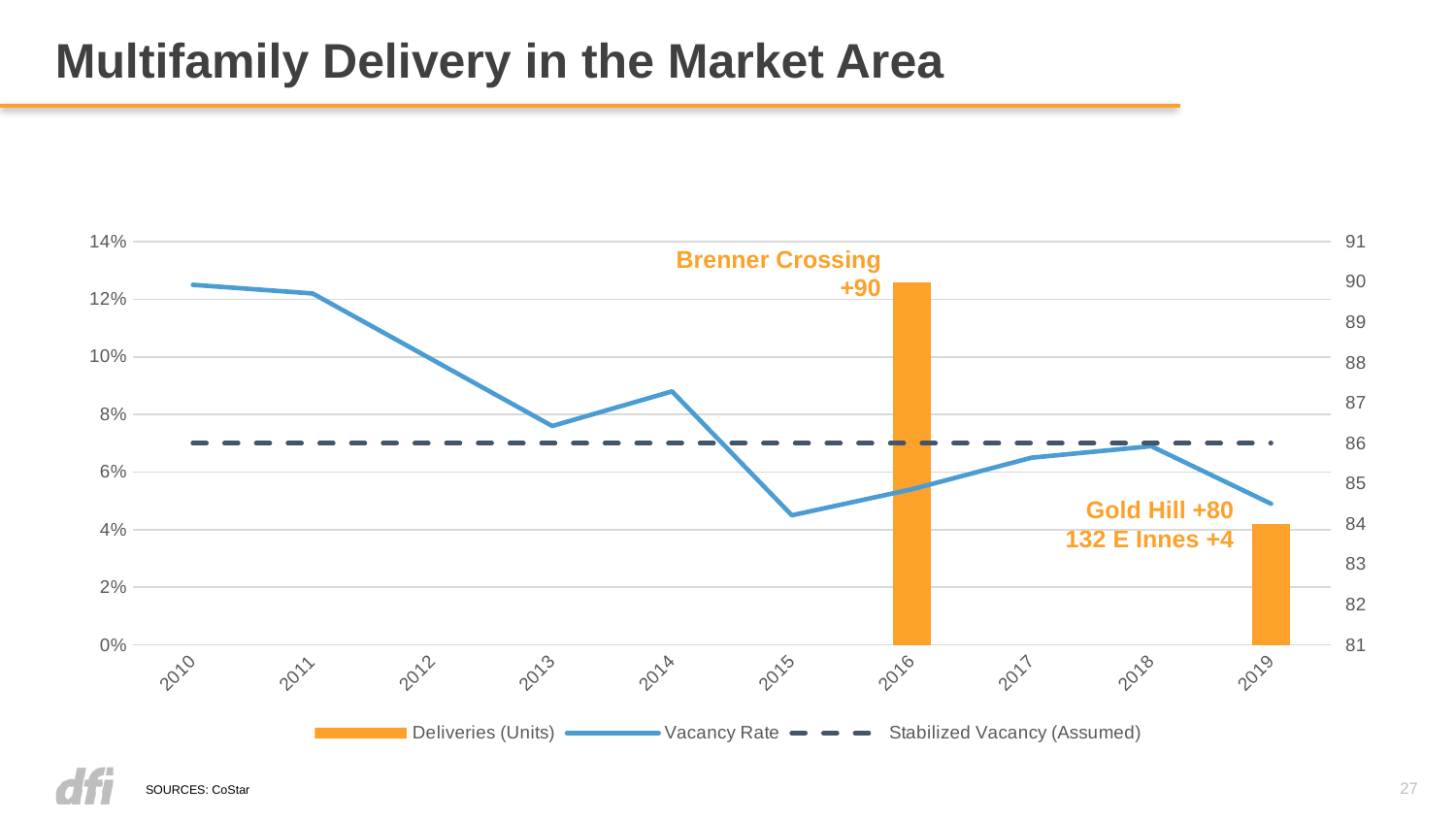
Is the vacancy rate in 2015 greater or less than 6%? less How many units did 132 E Innes add in 2019? +4 What kind of chart is shown on the slide? A combination bar and line chart How many units did Brenner Crossing add in 2016? +90 In which year was the vacancy rate highest? 2010 How many series does the legend list? 3 How many years are shown along the x axis? 10 Which year had the larger deliveries bar, 2016 or 2019? 2016 How many units did Gold Hill add in 2019? +80 In which year was the vacancy rate lowest? 2015 Does the vacancy rate rise or fall from 2010 to 2013? fall Is the vacancy rate in 2010 greater or less than 12%? greater